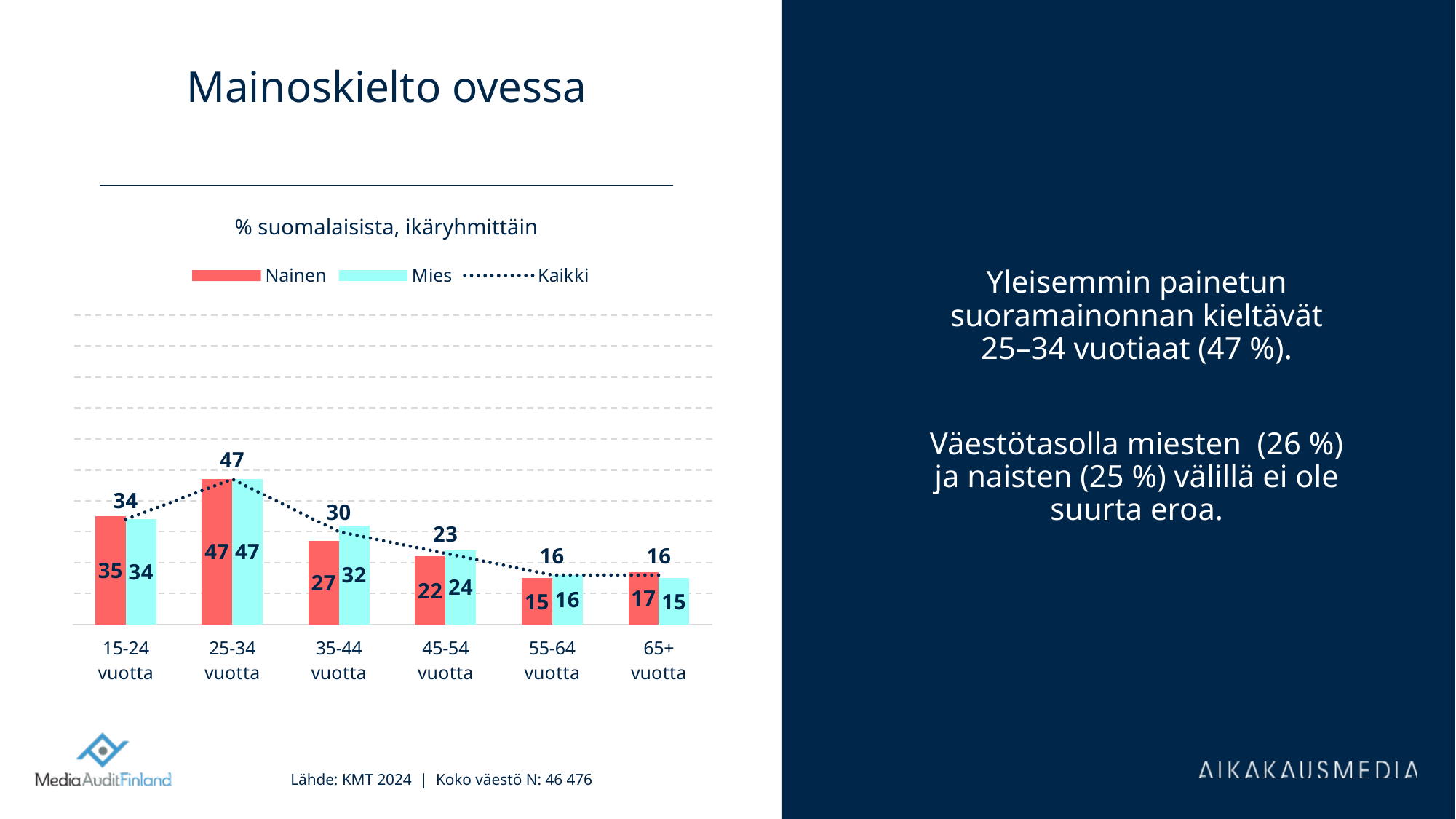
How many age groups are shown on the x axis? 6 How many series does the legend list? 3 What is the value for Nainen in the 15-24 vuotta age group? 35 In the 65+ vuotta age group, which is larger, Nainen or Mies? Nainen What is the value for Mies in the 35-44 vuotta age group? 32 Which age group has the lowest Nainen value? 55-64 vuotta Which age group has the highest Kaikki value? 25-34 vuotta What kind of chart is shown on the slide? Bar chart with a dotted line What is the Kaikki value for the 45-54 vuotta age group? 23 Which series is shown in red in the legend? Nainen Do the Kaikki values rise or fall from the 25-34 vuotta group to the 55-64 vuotta group? Fall What is the difference between the Mies and Nainen values in the 35-44 vuotta age group? 5